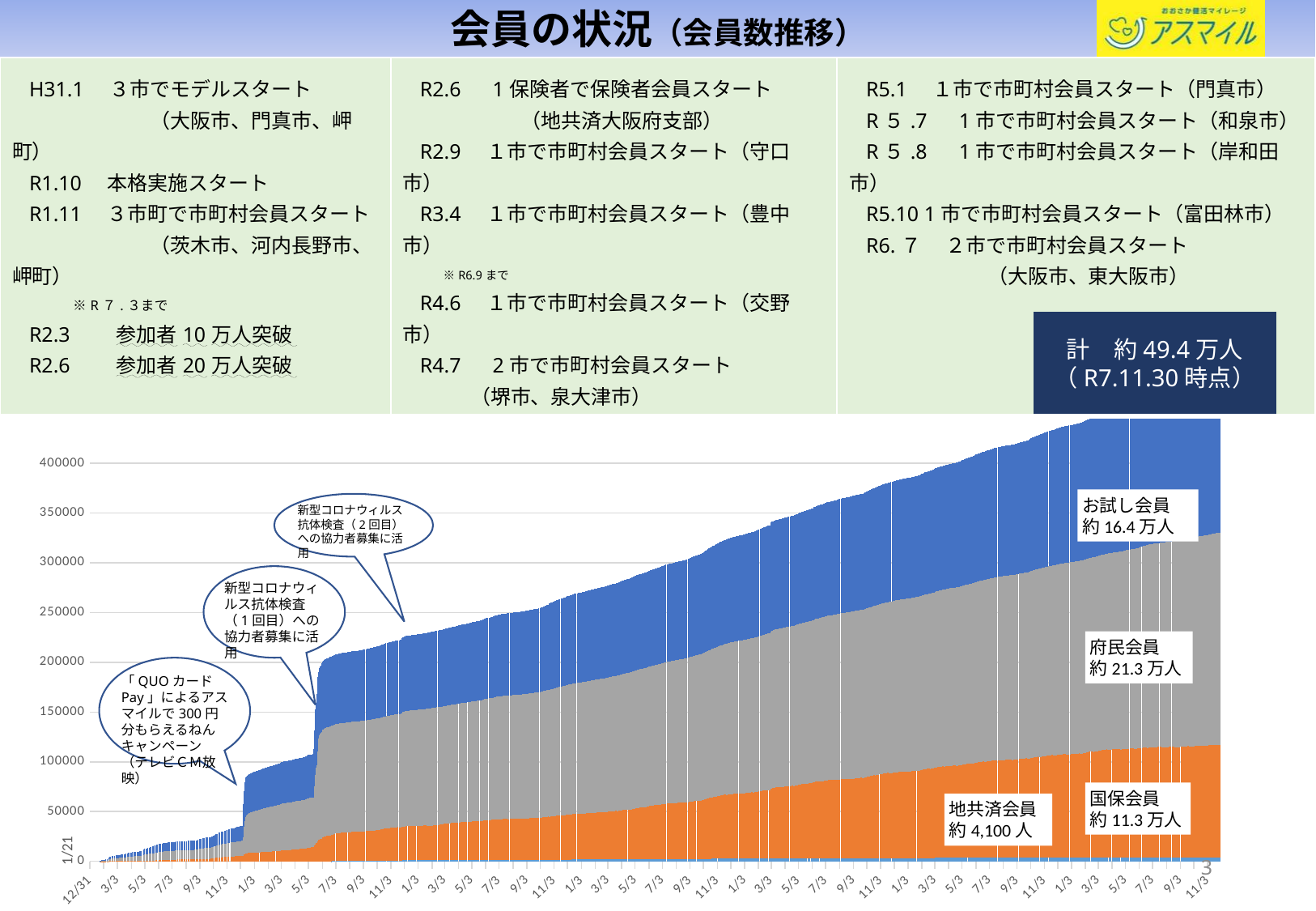
Is the total member count at the right end of the chart greater or less than 400000? greater What is the number of 地共済会員 shown on the chart? 約4,100人 Do the total member numbers rise or fall over time along the x axis? rise What is the highest value labelled on the vertical axis of the chart? 400000 Which is larger, the number of お試し会員 or the number of 国保会員? お試し会員 Which member category has the smallest number of members? 地共済会員 Which member category has the largest number of members? 府民会員 What is the number of 国保会員 shown on the chart? 約11.3万人 What is the number of 府民会員 shown on the chart? 約21.3万人 What is the number of お試し会員 shown on the chart? 約16.4万人 How many member categories are stacked in the chart? 4 What is the total number of members stated on the slide as of R7.11.30? 約49.4万人